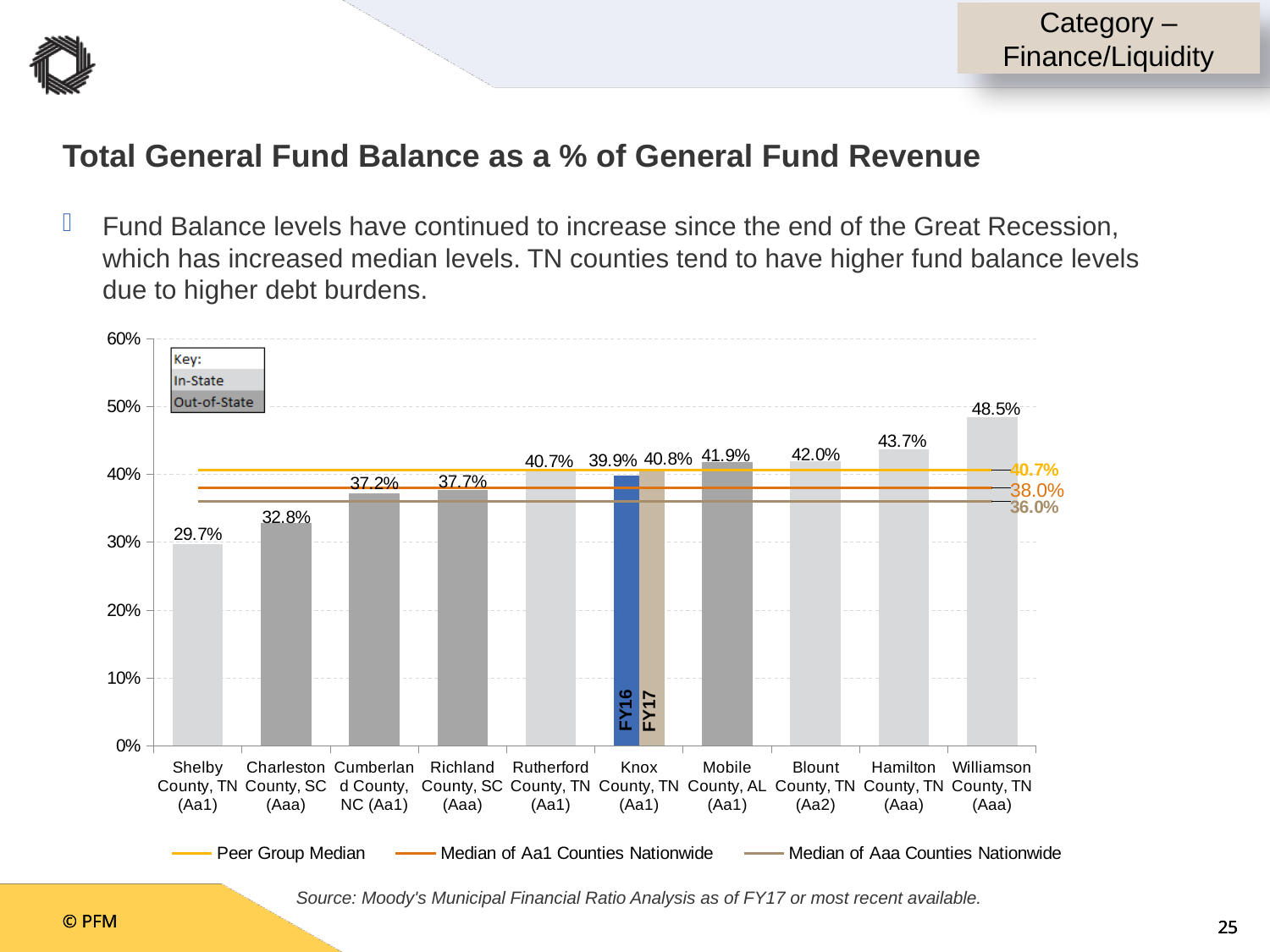
Which county has the highest value? Williamson County, TN (Aaa) What is the FY16 value for Knox County, TN (Aa1)? 39.9% What type of chart is shown on the slide? Bar chart What is the value of the Peer Group Median line? 40.7% What is the difference between the Knox County FY17 value and the Knox County FY16 value? 0.9% Which county has the lowest value? Shelby County, TN (Aa1) Which is larger, the value for Hamilton County, TN (Aaa) or the value for Mobile County, AL (Aa1)? Hamilton County, TN (Aaa) How many line series does the legend below the chart list? 3 What is the value for Williamson County, TN (Aaa)? 48.5% How many counties are shown on the x axis? 10 What is the FY17 value for Knox County, TN (Aa1)? 40.8% What is the value of the Median of Aaa Counties Nationwide line? 36.0%